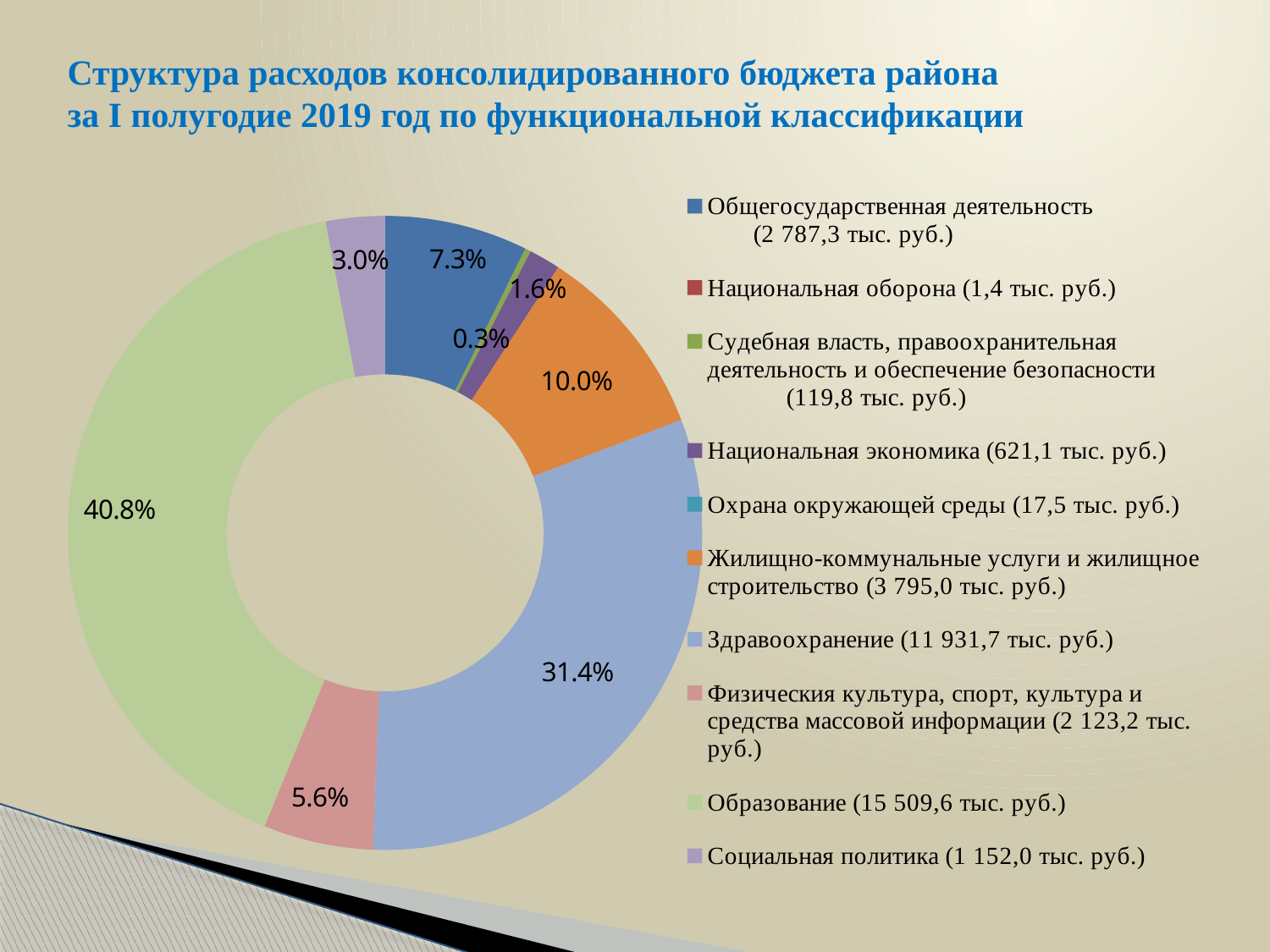
What kind of chart is shown on the slide? Doughnut (pie) chart What is the difference in percentage points between the shares for Образование and Здравоохранение? 9.4 percentage points What share of expenditures does Образование account for? 40.8% Which category has the largest share of expenditures? Образование According to the legend, what is the amount in thousand rubles for Образование? 15 509,6 тыс. руб. What share of expenditures does Национальная экономика account for? 1.6% Which is larger: the share for Здравоохранение or the share for Жилищно-коммунальные услуги и жилищное строительство? Здравоохранение What share of expenditures does Социальная политика account for? 3.0% What share of expenditures does Здравоохранение account for? 31.4% What share of expenditures does Общегосударственная деятельность account for? 7.3% What share of expenditures does Жилищно-коммунальные услуги и жилищное строительство account for? 10.0% How many categories does the legend list? 10